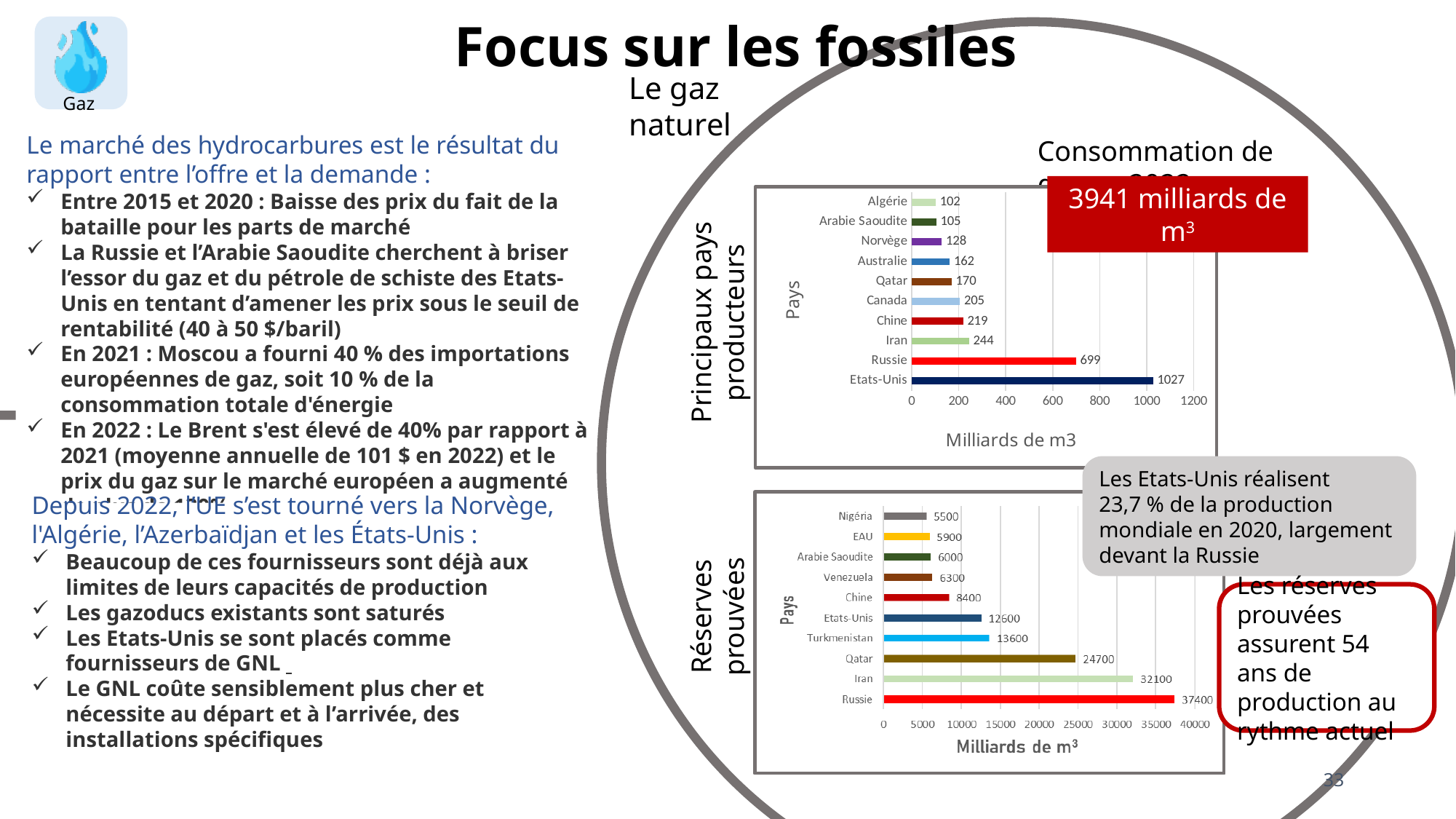
In the top chart (Principaux pays producteurs), which country has the lowest value? Algérie In the top chart (Principaux pays producteurs), how many countries are shown? 10 In the bottom chart (Réserves prouvées), what is the value for Qatar? 24700 In the bottom chart (Réserves prouvées), which country has the highest value? Russie In the top chart (Principaux pays producteurs), what is the value for Russie? 699 In the top chart (Principaux pays producteurs), which country has the highest value? Etats-Unis In the bottom chart (Réserves prouvées), what is the difference between Russie and Iran? 5300 In the top chart (Principaux pays producteurs), what is the difference between Etats-Unis and Russie? 328 What type of chart is the bottom chart (Réserves prouvées)? Bar chart In the bottom chart (Réserves prouvées), which is larger, Iran or Etats-Unis? Iran In the top chart (Principaux pays producteurs), what is the x-axis label? Milliards de m3 In the bottom chart (Réserves prouvées), which country has the lowest value? Nigéria